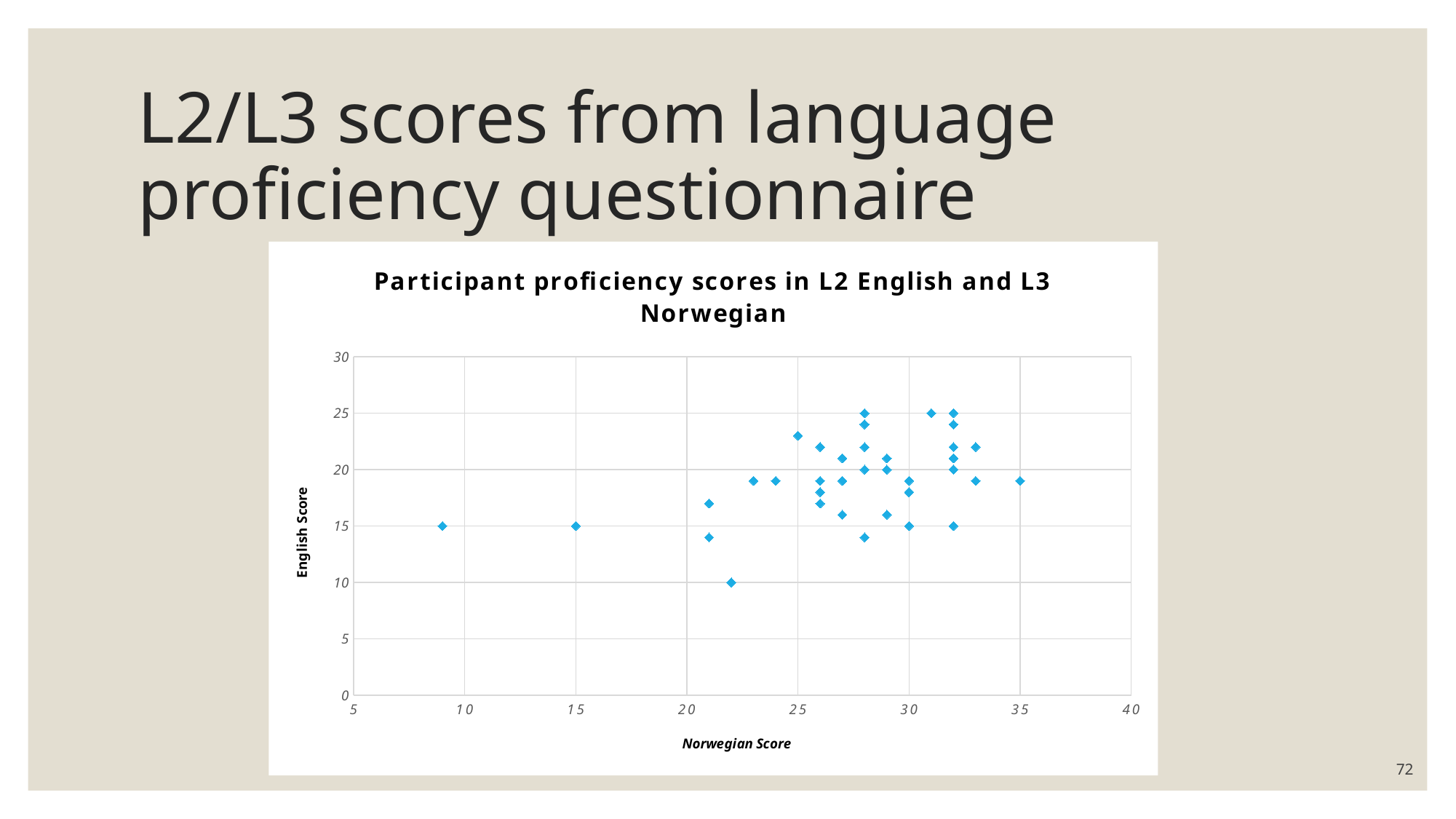
What is the highest Norwegian Score plotted on the chart? 35 Are there more points with a Norwegian Score above 20 or below 20? above 20 Is the lowest Norwegian Score plotted greater or less than 10? less Is the English Score of the point with the lowest Norwegian Score greater or less than 20? less Is the maximum value shown on the English Score axis greater or less than 25? greater What is the title of the chart? Participant proficiency scores in L2 English and L3 Norwegian What is the lowest English Score plotted on the chart? 10 What kind of chart is shown on the slide? scatter chart What is the label of the horizontal axis? Norwegian Score What is the highest English Score plotted on the chart? 25 Do English Scores generally rise or fall as Norwegian Scores increase along the x axis? rise